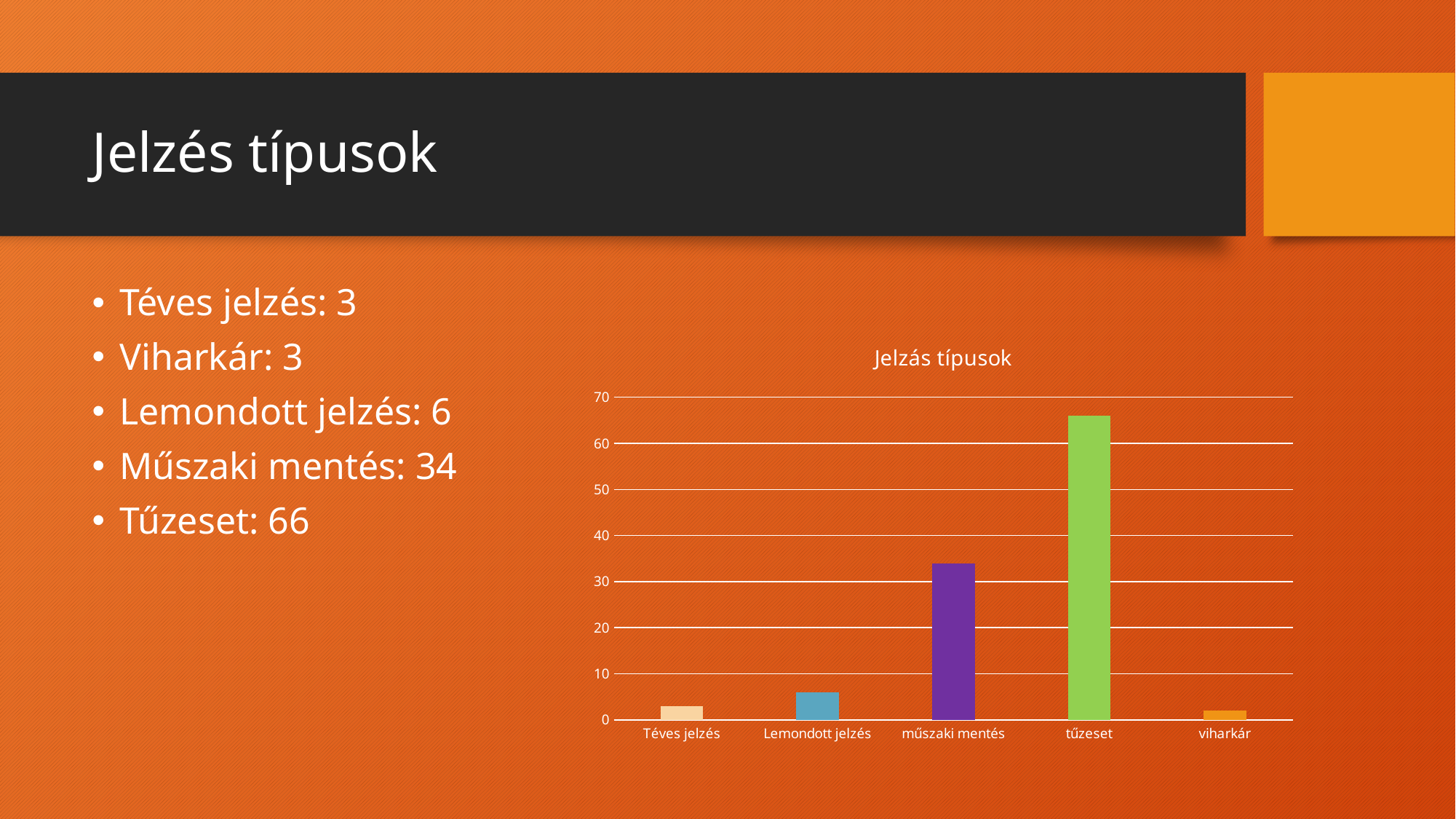
What kind of chart is shown on the slide? bar chart What is the difference between the values for tűzeset and műszaki mentés? 32 What is the value for műszaki mentés? 34 What is the title of the chart? Jelzás típusok Is the value for Lemondott jelzés greater or less than 10? less Is the value for tűzeset greater or less than 60? greater Which category has the highest bar in the chart? tűzeset Which is larger, the value for műszaki mentés or the value for Lemondott jelzés? műszaki mentés How many categories are shown on the x axis of the chart? 5 What is the value for tűzeset? 66 Is the value for műszaki mentés greater or less than 30? greater What is the value for Lemondott jelzés? 6